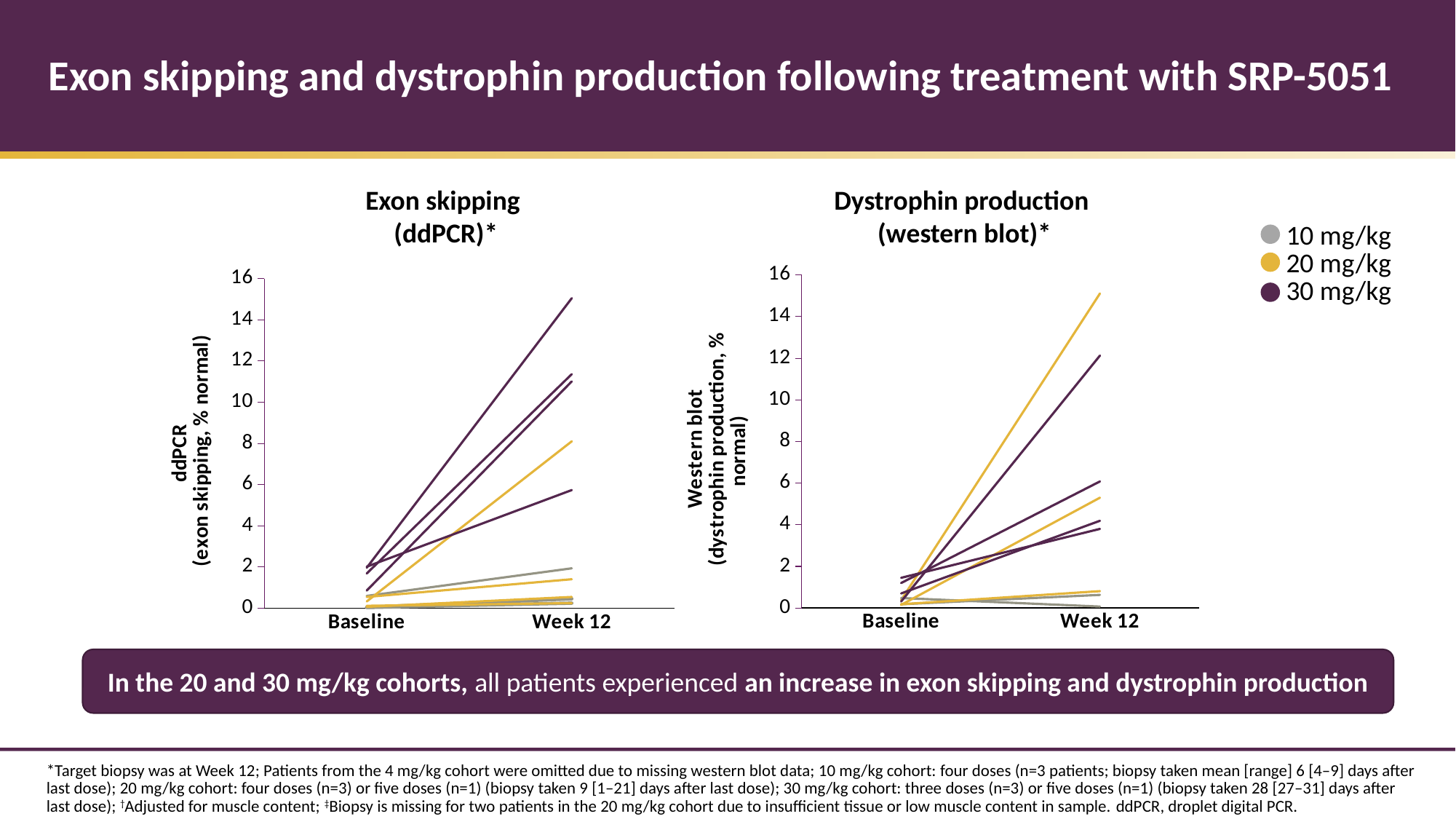
In the 'Dystrophin production (western blot)' chart, are the 10 mg/kg values at Week 12 greater or less than 2? less How many dose cohorts does the legend list? 3 In the 'Exon skipping (ddPCR)' chart, are the 10 mg/kg values at Week 12 greater or less than 4? less In the 'Dystrophin production (western blot)' chart, which dose cohort has the highest value at Week 12? 20 mg/kg Which colour represents the 20 mg/kg cohort in the legend? Yellow In the 'Exon skipping (ddPCR)' chart, which dose cohort has the highest value at Week 12? 30 mg/kg In the 'Exon skipping (ddPCR)' chart, do the 30 mg/kg lines rise or fall from Baseline to Week 12? Rise In the 'Dystrophin production (western blot)' chart, is the highest 30 mg/kg value at Week 12 greater or less than 10? greater What is the maximum value shown on the y axis of the 'Dystrophin production (western blot)' chart? 16 How many time points are shown on the x axis of the 'Dystrophin production (western blot)' chart? 2 What kind of chart is the 'Exon skipping (ddPCR)' chart? Line chart